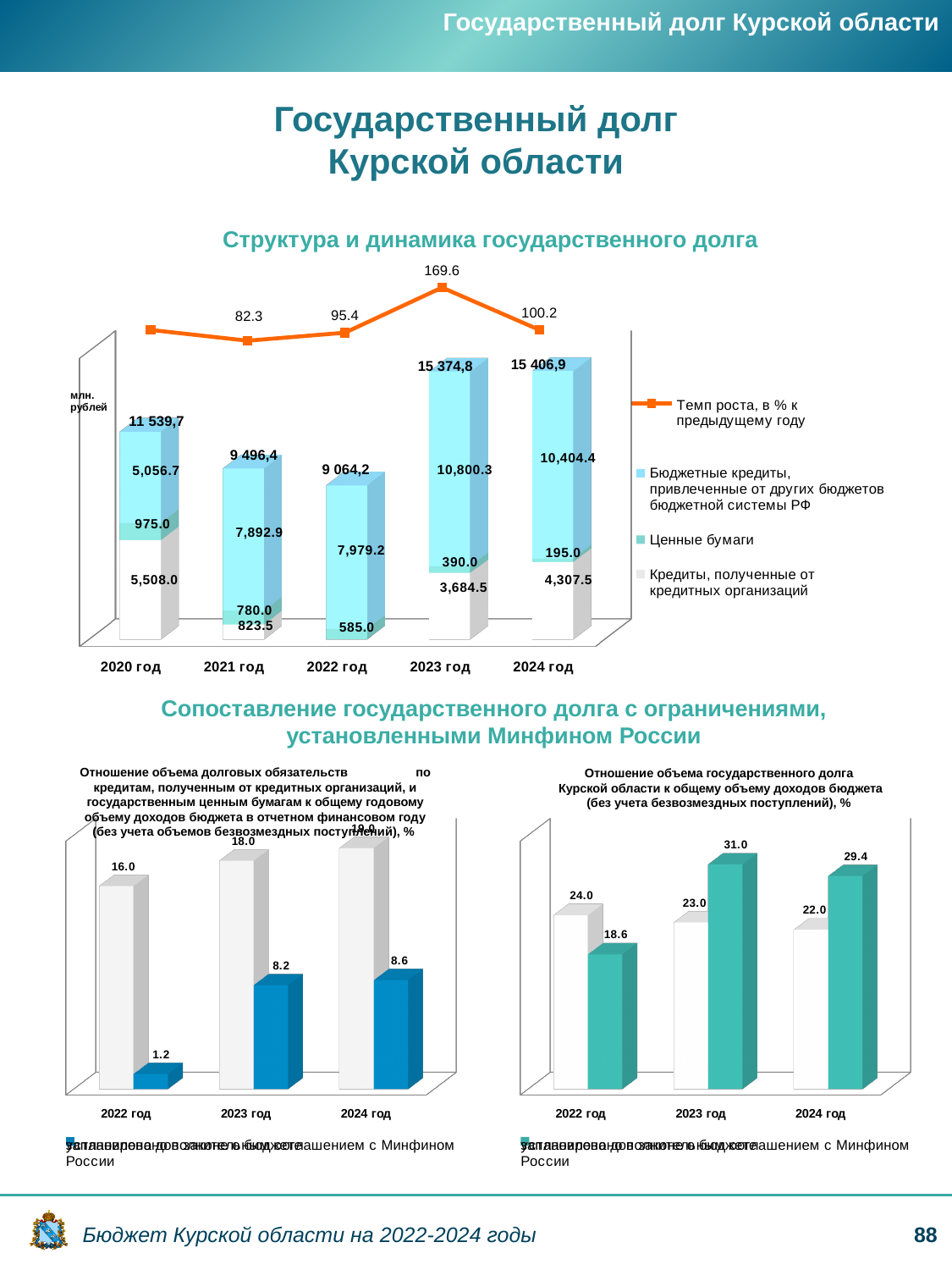
In the chart 'Структура и динамика государственного долга', how many series does the legend list? 4 In the chart 'Структура и динамика государственного долга', what is the difference between the 'Кредиты, полученные от кредитных организаций' values for 2024 год and 2023 год? 623.0 In the chart 'Структура и динамика государственного долга', what is the value of 'Бюджетные кредиты, привлеченные от других бюджетов бюджетной системы РФ' for 2021 год? 7,892.9 In the chart 'Структура и динамика государственного долга', how many years are shown on the x axis? 5 In the bottom-left chart ('Отношение объема долговых обязательств по кредитам...'), what is the difference between the white bar and the blue bar for 2024 год? 10.4 In the chart 'Структура и динамика государственного долга', what is the total state debt for 2023 год? 15 374,8 In the bottom-right chart ('Отношение объема государственного долга Курской области к общему объему доходов бюджета...'), which year has the highest teal bar? 2023 год In the chart 'Структура и динамика государственного долга', what is the 'Темп роста, в % к предыдущему году' value for 2023 год? 169.6 In the chart 'Структура и динамика государственного долга', what is the value of 'Ценные бумаги' for 2024 год? 195.0 In the chart 'Структура и динамика государственного долга', which year has the lowest total state debt? 2022 год In the bottom-left chart ('Отношение объема долговых обязательств по кредитам...'), what is the value of the blue bar for 2022 год? 1.2 In the bottom-right chart ('Отношение объема государственного долга Курской области к общему объему доходов бюджета...'), which is larger for 2022 год: the white bar or the teal bar? the white bar (24.0)